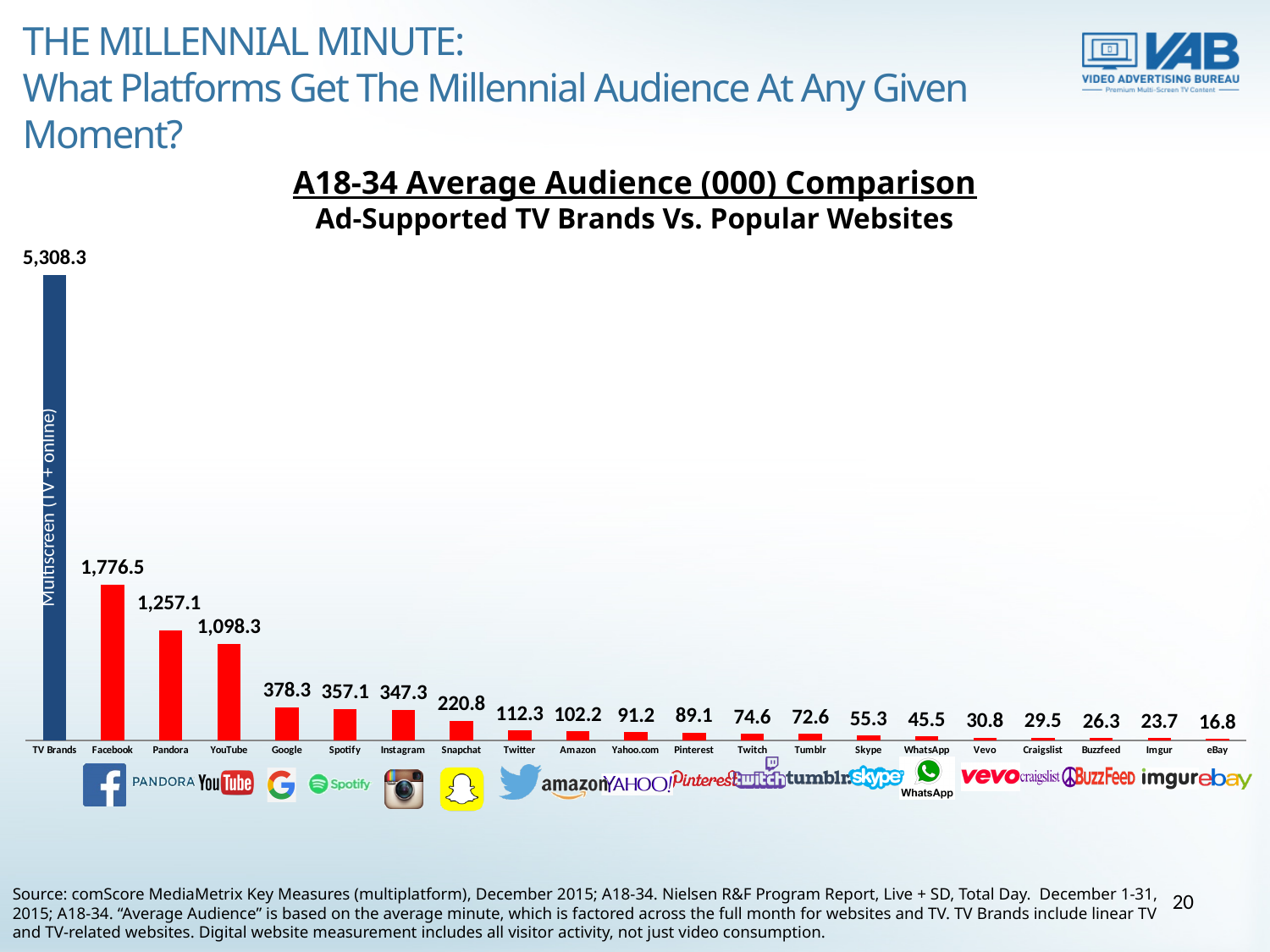
Which has a larger value, Pandora or YouTube? Pandora Which category has the highest value? TV Brands What is the value for Facebook? 1,776.5 What is the difference between the values for Facebook and Pandora? 519.4 What is the value for eBay? 16.8 What is the value for Snapchat? 220.8 Do the values rise or fall from left to right along the x axis? Fall What kind of chart is this? Bar chart Which category has the lowest value? eBay How many categories are shown in the chart? 21 What is the value for Twitch? 74.6 What is the difference between the values for TV Brands and Facebook? 3,531.8